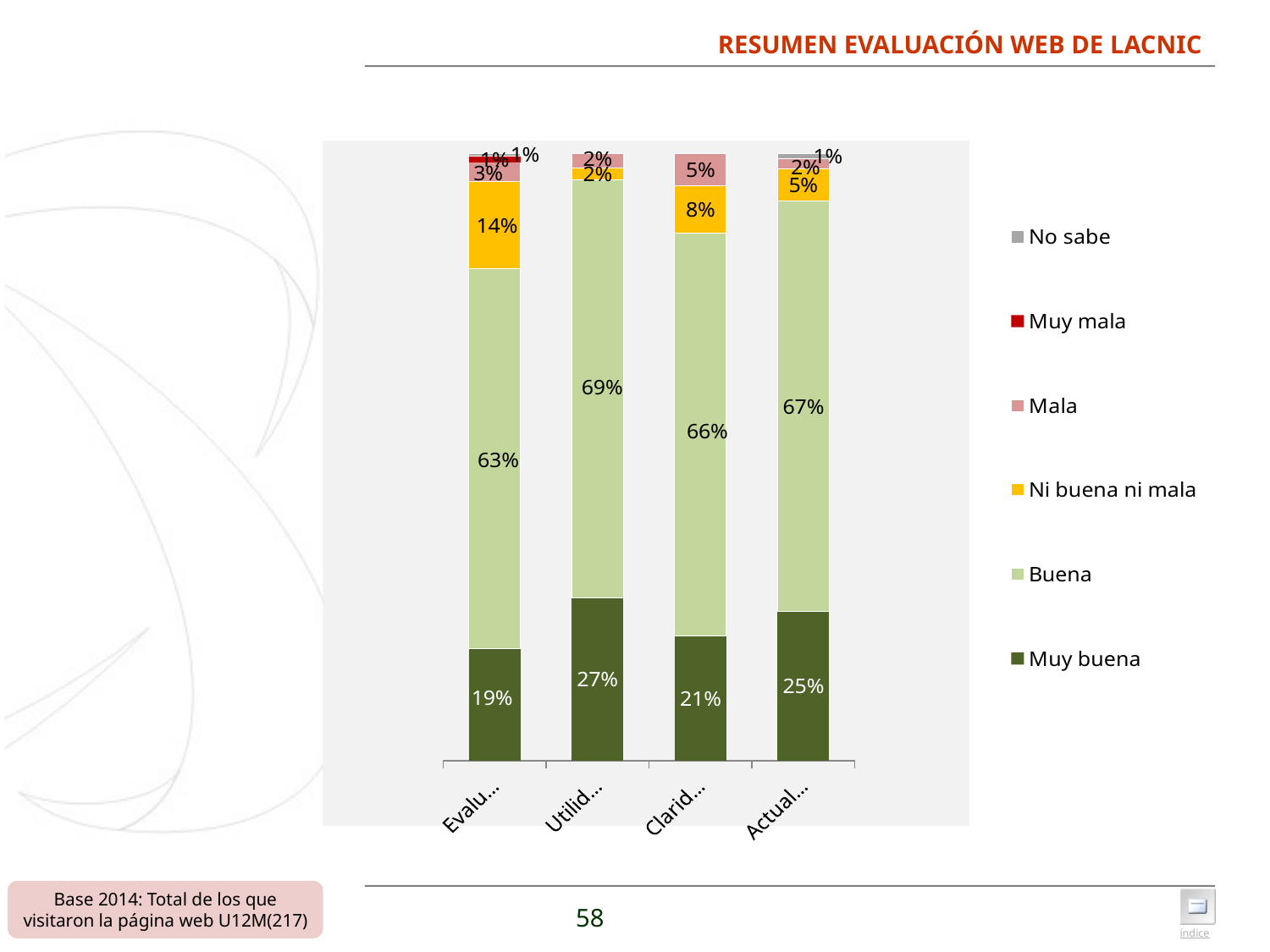
What is the 'Mala' value for the third bar (Clarid...)? 5% What is the 'Buena' value for the second bar (Utilid...)? 69% What is the 'Muy buena' value for the fourth bar (Actual...)? 25% What kind of chart is shown on the slide? Stacked bar chart Which colour represents 'Muy buena' in the chart? Dark green How many bars (categories) are plotted in the chart? 4 Which category has the lowest 'Muy buena' value? Evalu... (19%) What is the 'Ni buena ni mala' value for the first bar (Evalu...)? 14% Which has a larger 'Ni buena ni mala' value, Evalu... or Clarid...? Evalu... Which category has the highest 'Muy buena' value? Utilid... (27%) How many series does the chart legend list? 6 What is the difference between the 'Buena' values of Utilid... and Evalu...? 6 percentage points